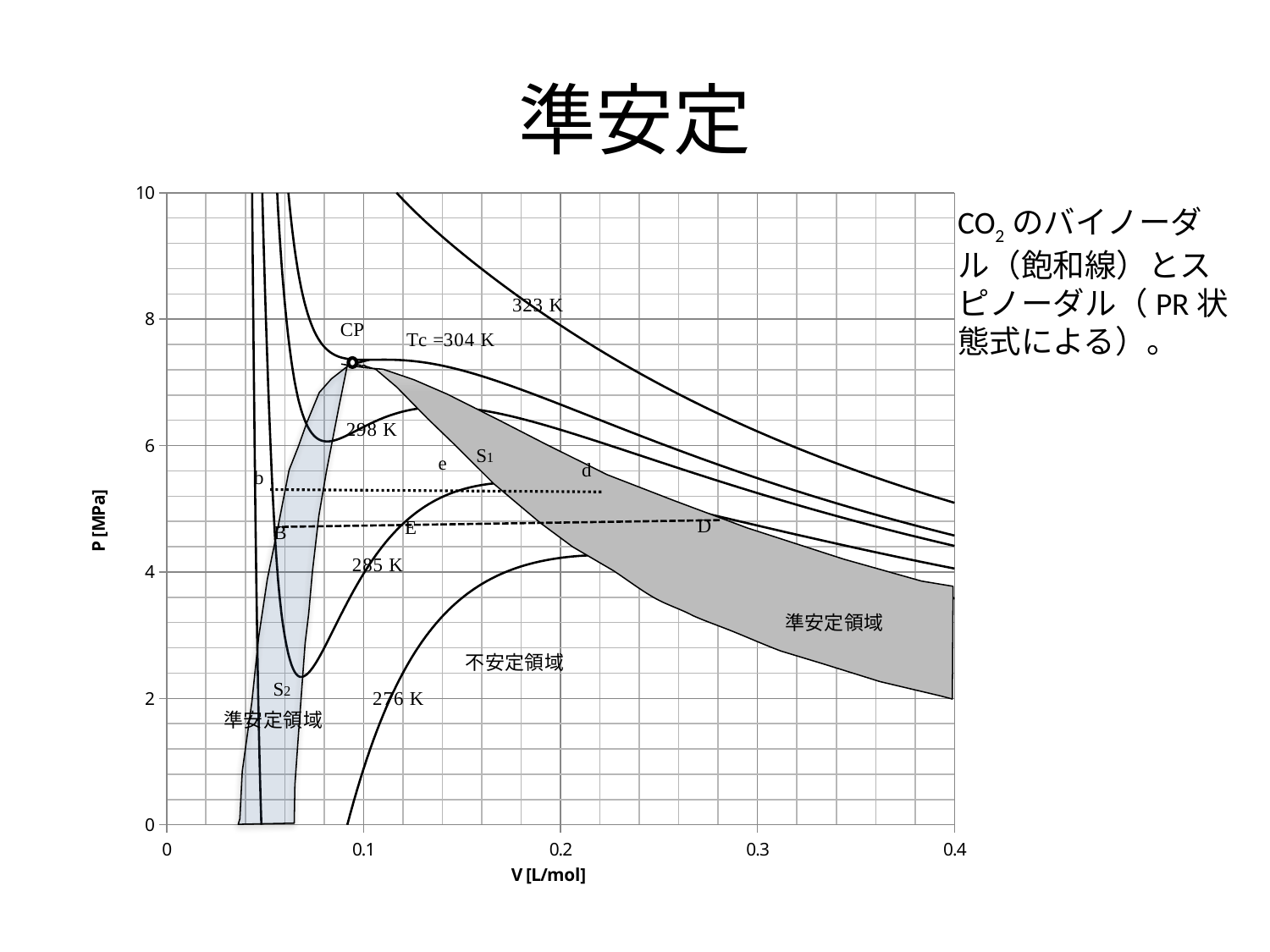
What kind of chart is shown on the slide? line chart Is the pressure at the critical point CP greater or less than 6 MPa? greater What critical temperature Tc is printed on the chart? Tc =304 K At V = 0.3 L/mol, which isotherm has the higher pressure, 323 K or 276 K? 323 K Along the 323 K isotherm, does the pressure rise or fall as the volume V increases? fall How many isotherms are labeled with a temperature on the chart? 5 What is the difference in temperature between the 323 K isotherm and the 276 K isotherm? 47 K What is the label of the horizontal axis of the chart? V [L/mol] What is the label of the vertical axis of the chart? P [MPa] Is the pressure at point S2 greater or less than 4 MPa? less Which labeled isotherm has the highest temperature? 323 K Which labeled isotherm has the lowest temperature? 276 K